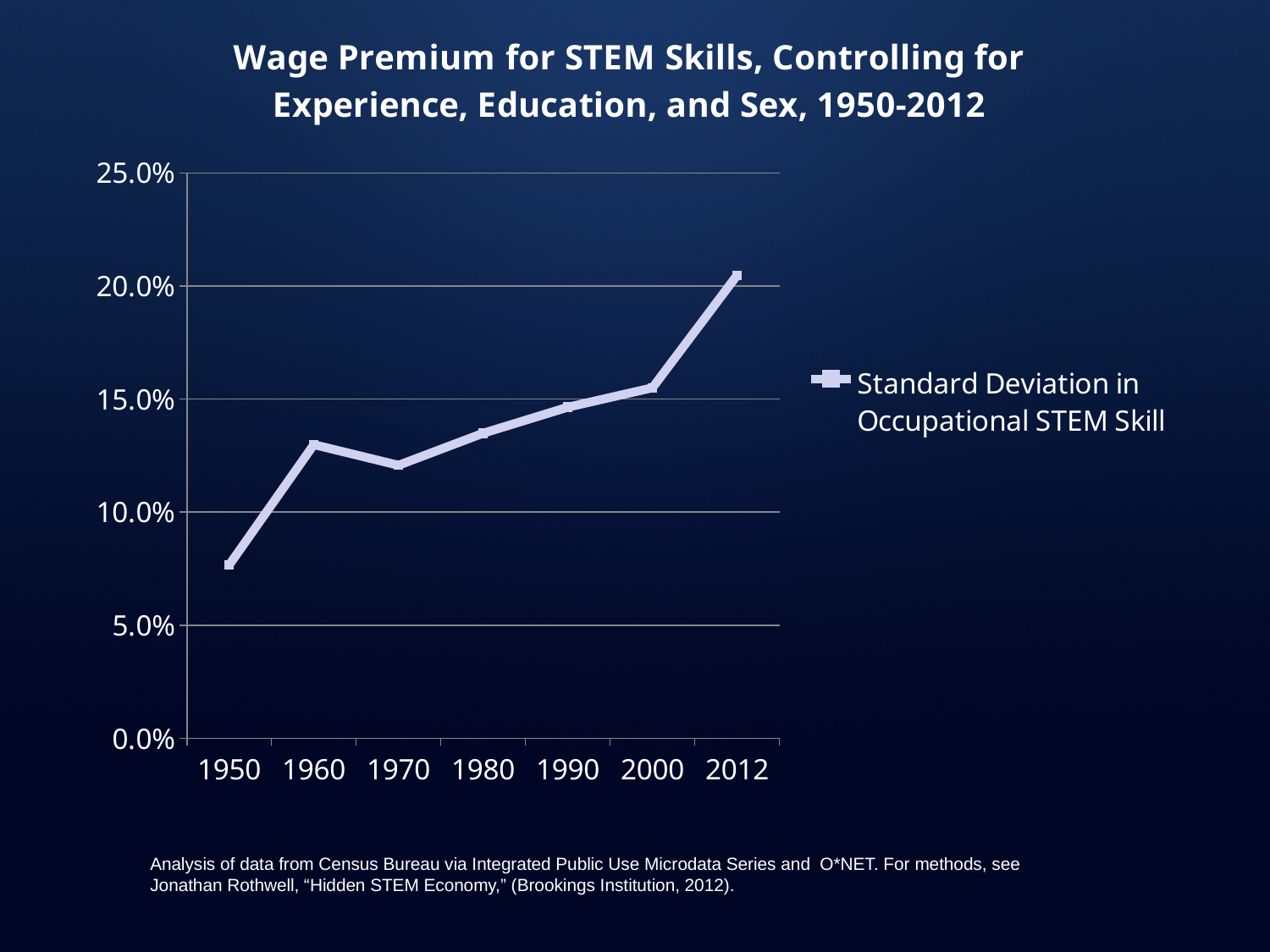
Is the value for 1950 greater or less than 10.0%? less How many series does the legend list? 1 What is the name of the series shown in the legend? Standard Deviation in Occupational STEM Skill Which year has the lowest wage premium value? 1950 Is the value for 1980 greater or less than 10.0%? greater Is the value for 2012 greater or less than 15.0%? greater Overall, do the values rise or fall from 1950 to 2012? rise What kind of chart is shown on the slide? line chart Which year has the highest wage premium value? 2012 How many years are plotted along the x axis? 7 Which year has the larger value, 1960 or 1970? 1960